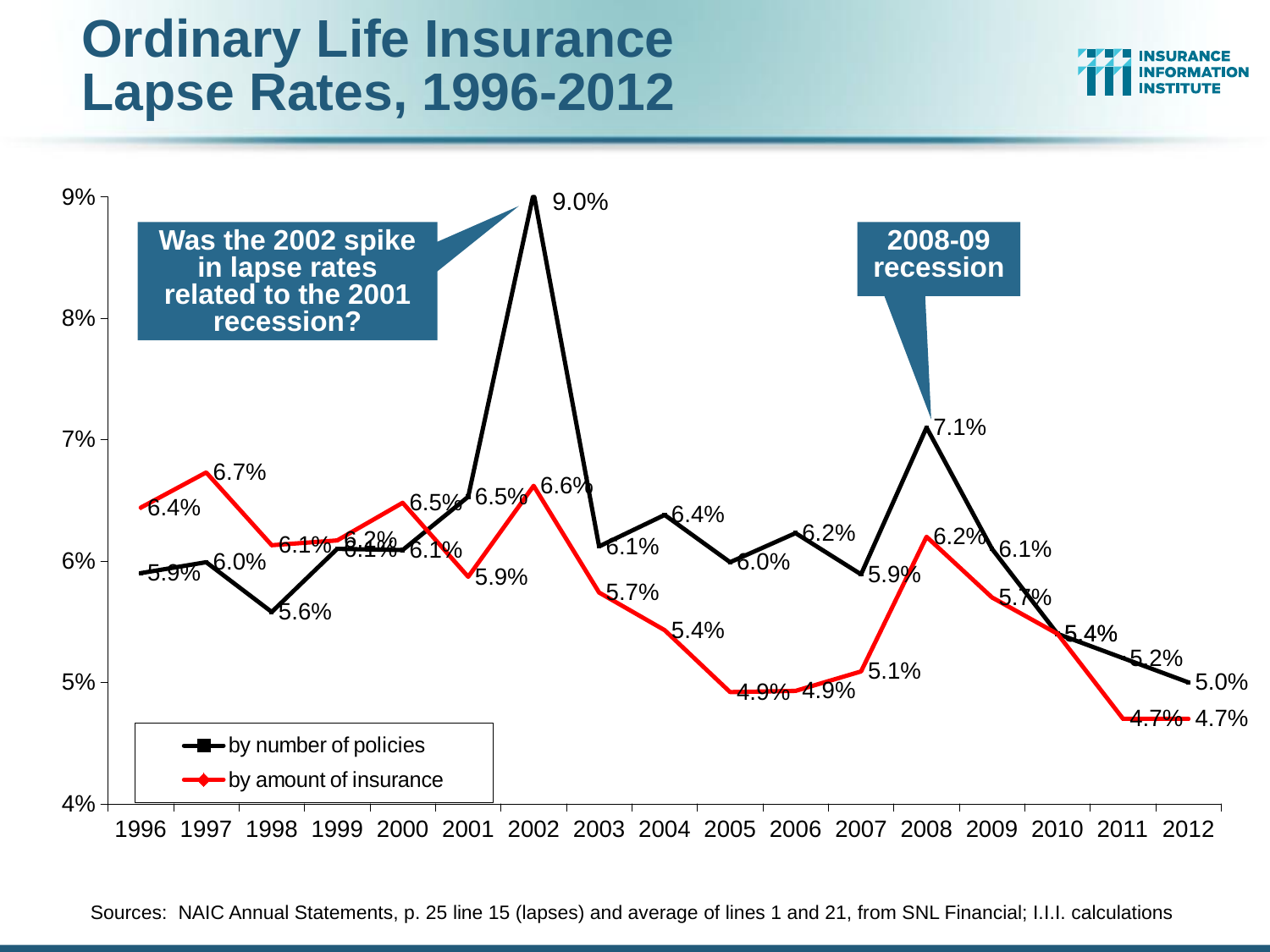
What is the lapse rate by amount of insurance in 1997? 6.7% What is the difference between the lapse rate by number of policies in 2002 and in 2003? 2.9% Which is larger in 1997: the lapse rate by number of policies or by amount of insurance? by amount of insurance What is the lapse rate by amount of insurance in 2005? 4.9% What is the lapse rate by number of policies in 2002? 9.0% In which year is the lapse rate by number of policies lowest? 2012 How many years are shown on the x axis? 17 In which year is the lapse rate by number of policies highest? 2002 How many series does the legend list? 2 What is the lapse rate by number of policies in 2008? 7.1% What kind of chart is shown on the slide? line chart Is the lapse rate by number of policies in 2008 greater or less than 7%? greater